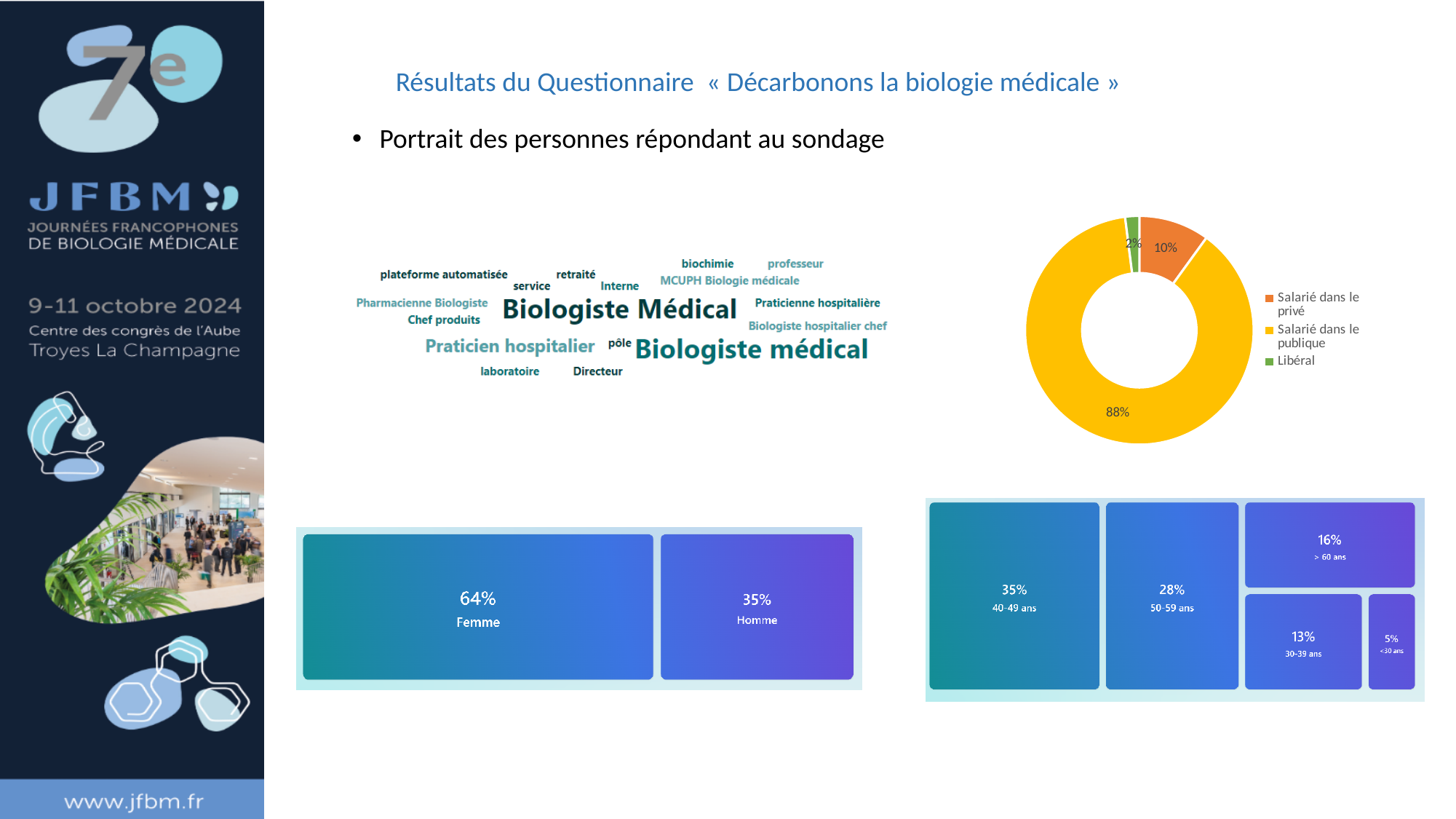
In the donut chart at the top right, how many categories does the legend list? 3 In the donut chart at the top right, what share of respondents are 'Libéral'? 2% In the age chart at the bottom right, how many age groups are shown? 5 In the donut chart at the top right, what share of respondents are 'Salarié dans le privé'? 10% In the age chart at the bottom right, what percentage of respondents are in the '50-59 ans' group? 28% In the gender chart at the bottom left, what percentage of respondents are 'Femme'? 64% In the age chart at the bottom right, which age group has the largest share? 40-49 ans In the donut chart at the top right, what share of respondents are 'Salarié dans le publique'? 88% In the donut chart at the top right, which category has the smallest share? Libéral In the age chart at the bottom right, what is the difference between the '> 60 ans' and '30-39 ans' shares? 3 percentage points In the donut chart at the top right, what is the difference between the shares for 'Salarié dans le publique' and 'Salarié dans le privé'? 78 percentage points In the gender chart at the bottom left, what percentage of respondents are 'Homme'? 35%